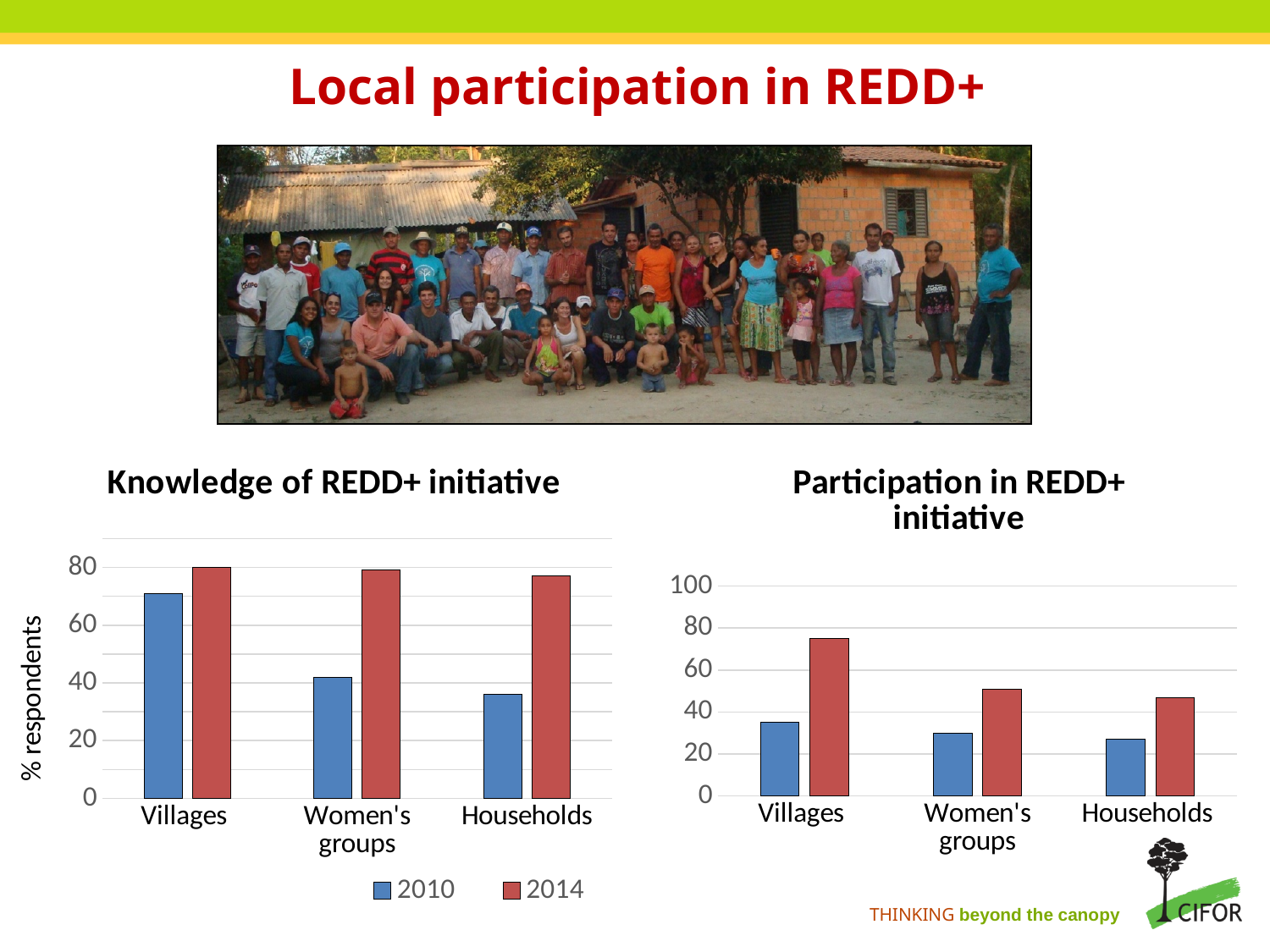
In the 'Participation in REDD+ initiative' chart, which category has the highest 2014 value? Villages What kind of chart is the 'Knowledge of REDD+ initiative' chart? bar chart In the 'Participation in REDD+ initiative' chart, is the 2010 value for Households greater or less than 40? less In the 'Knowledge of REDD+ initiative' chart, do the 2010 values rise or fall from Villages to Households? fall In the 'Participation in REDD+ initiative' chart, is the 2014 value for Villages greater or less than 60? greater In the 'Participation in REDD+ initiative' chart, which is larger for Women's groups: the 2010 value or the 2014 value? 2014 How many series does the legend below the 'Knowledge of REDD+ initiative' chart list? 2 What is the label on the vertical axis of the 'Knowledge of REDD+ initiative' chart? % respondents In the 'Knowledge of REDD+ initiative' chart, is the 2010 value for Households greater or less than 40? less How many categories are shown on the x axis of the 'Participation in REDD+ initiative' chart? 3 In the 'Knowledge of REDD+ initiative' chart, which category has the lowest 2010 value? Households